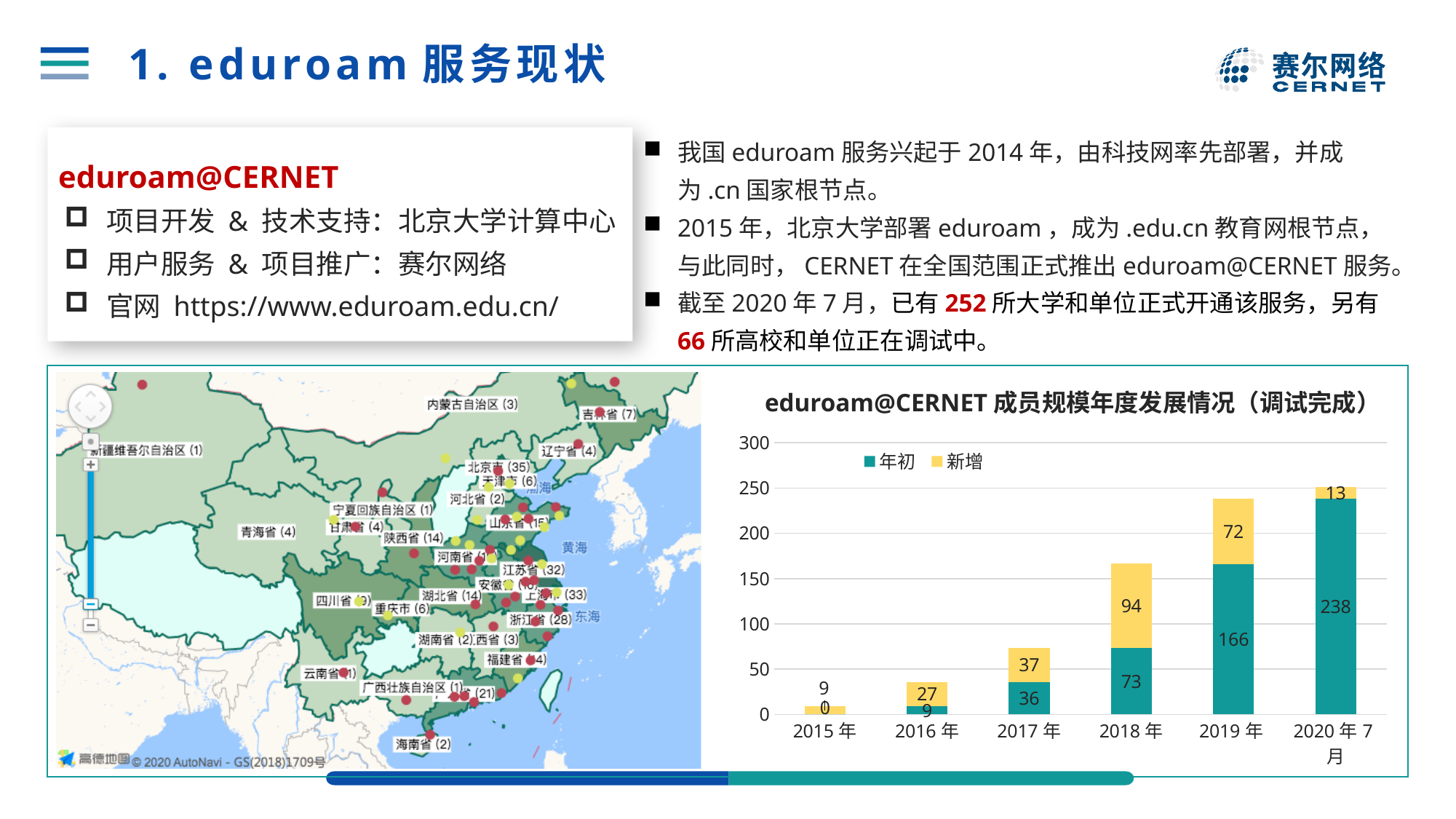
In the bar chart, what is the total of the stacked bar for 2018 年? 167 How many categories are shown on the x axis of the bar chart? 6 How many series does the legend of the bar chart list? 2 What kind of chart is shown on the right side of the slide? stacked bar chart In the bar chart, is the 新增 value for 2017 年 larger than the 新增 value for 2019 年? No In the bar chart, what is the 新增 value for 2018 年? 94 In the bar chart, what is the 年初 value for 2020 年 7 月? 238 In the bar chart, what is the 年初 value for 2019 年? 166 In the bar chart, which category has the lowest 年初 value? 2015 年 In the bar chart, which year has the highest 新增 value? 2018 年 In the bar chart, what is the difference between the 年初 values for 2019 年 and 2018 年? 93 Do the 年初 values in the bar chart rise or fall from 2015 年 to 2020 年 7 月? rise